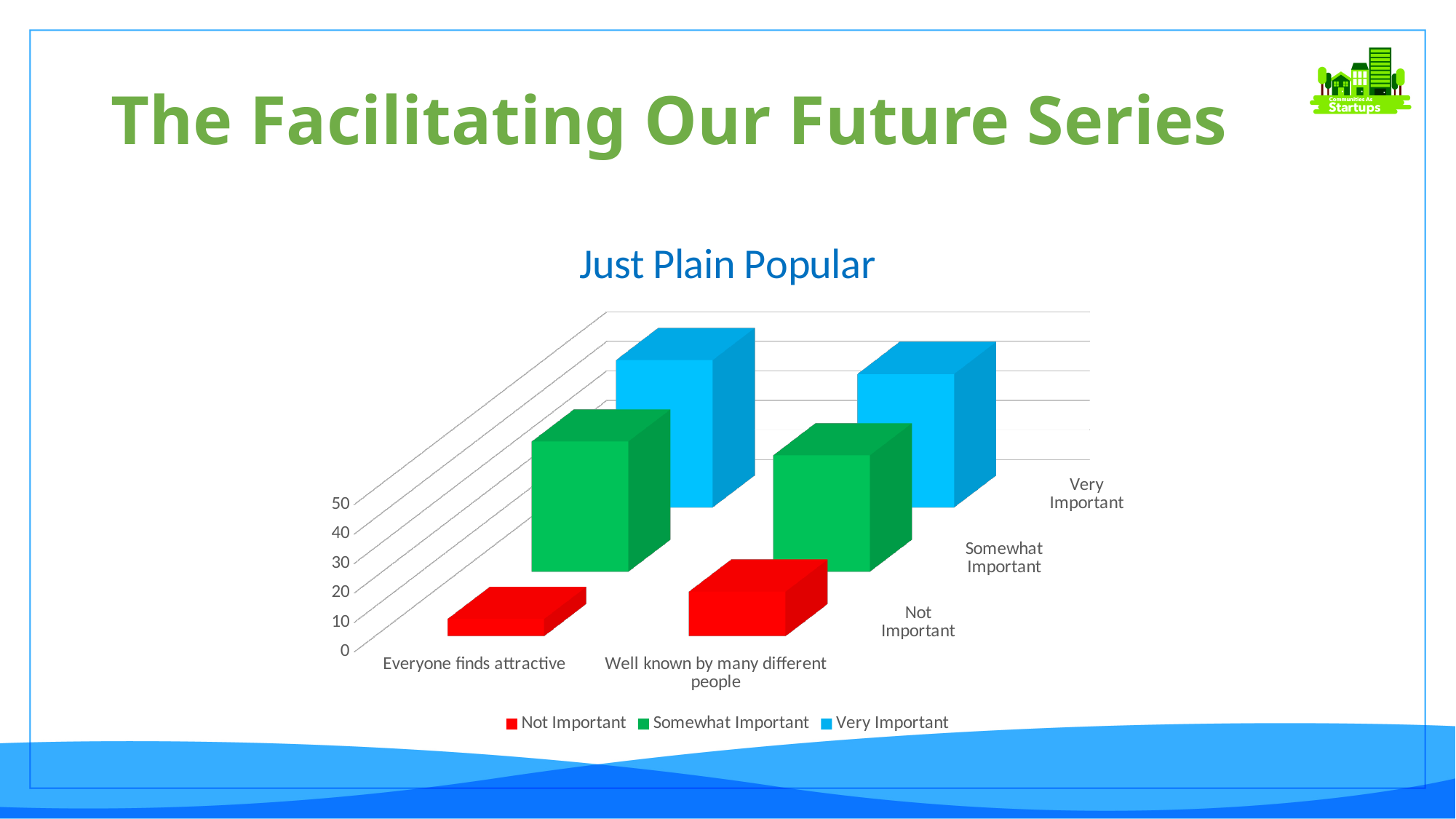
Is the 'Not Important' value for 'Everyone finds attractive' greater or less than 20? less For 'Well known by many different people', which is larger: the 'Somewhat Important' value or the 'Not Important' value? Somewhat Important What is the title of the chart? Just Plain Popular For 'Everyone finds attractive', which series has the highest value? Very Important For 'Everyone finds attractive', which is larger: the 'Very Important' value or the 'Not Important' value? Very Important How many categories are shown on the x axis of the chart? 2 How many series does the legend list? 3 For 'Well known by many different people', which series has the lowest value? Not Important Which colour represents the 'Very Important' series in the chart? blue Is the 'Very Important' value for 'Everyone finds attractive' greater or less than 30? greater What kind of chart is shown on the slide? bar chart Is the 'Somewhat Important' value for 'Well known by many different people' greater or less than 20? greater